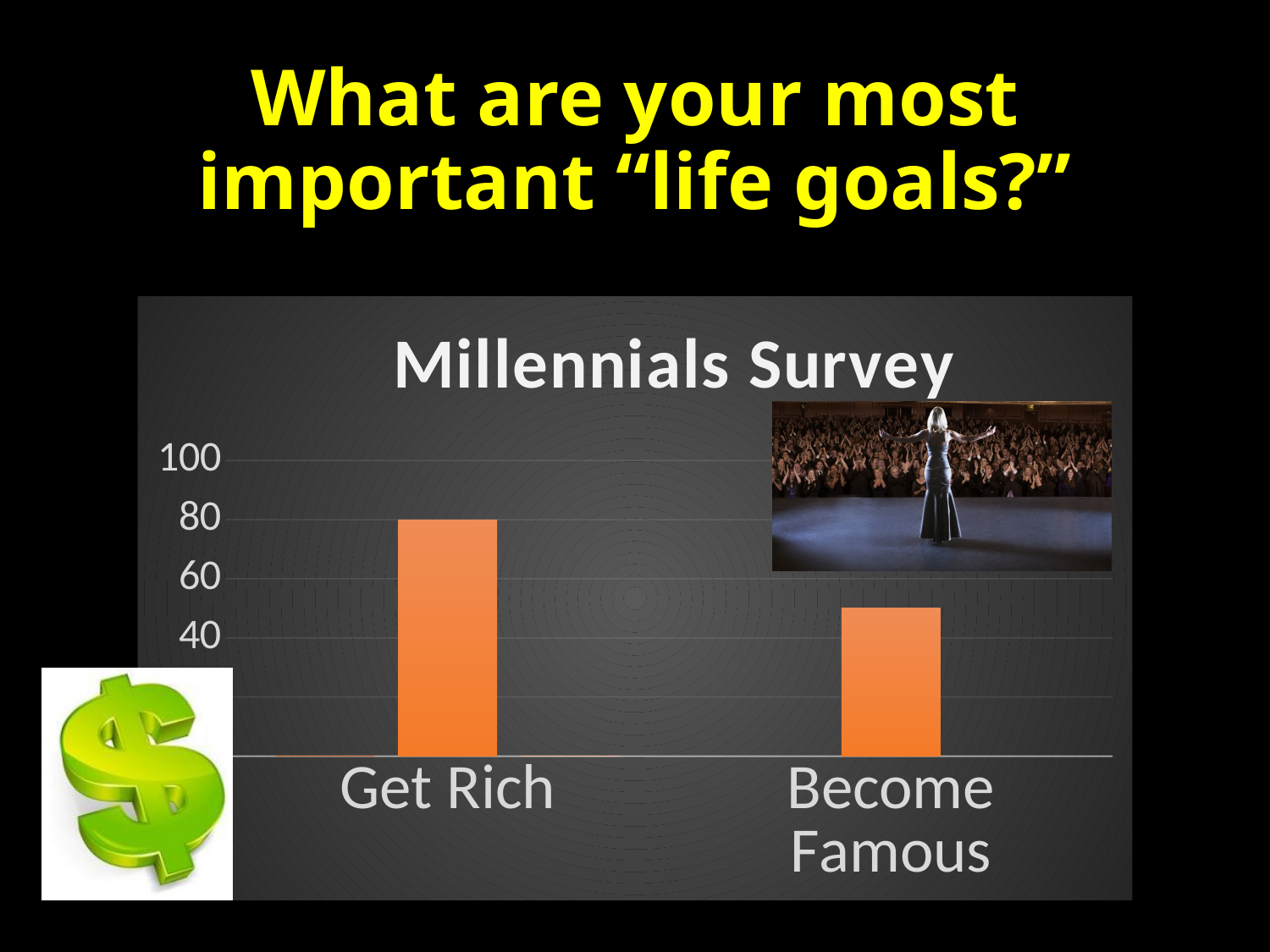
What kind of chart is shown on the slide? bar chart Is the value for Become Famous greater or less than 40? greater Is the value for Get Rich greater or less than 60? greater Is the value for Become Famous greater or less than 60? less Which category has the lowest value in the chart? Become Famous Which category has the highest value in the chart? Get Rich Which is larger, the value for Get Rich or the value for Become Famous? Get Rich What value does the Get Rich bar reach on the axis? 80 What is the title of the chart? Millennials Survey How many categories are shown on the x axis of the chart? 2 What colour are the bars in the chart? orange